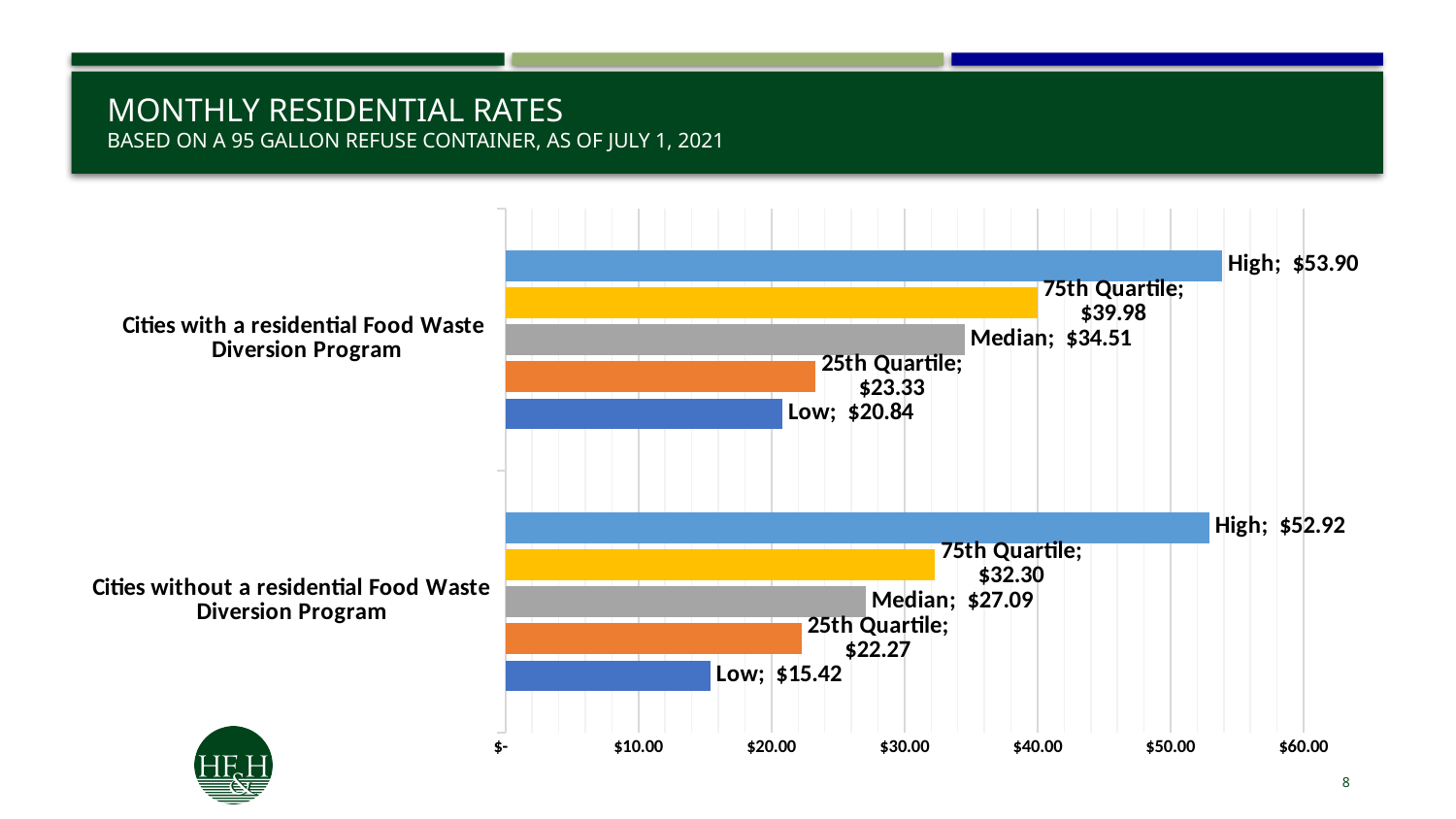
What kind of chart is shown on the slide? Bar chart Which category has the lower Low value? Cities without a residential Food Waste Diversion Program What is the difference between the Median values of the two categories? $7.42 What is the High value for cities with a residential Food Waste Diversion Program? $53.90 What is the title of the slide's chart? Monthly Residential Rates Which is larger: the 75th Quartile for cities with a program or the 75th Quartile for cities without a program? Cities with a residential Food Waste Diversion Program What is the 75th Quartile value for cities without a residential Food Waste Diversion Program? $32.30 How many categories are shown on the chart? 2 What is the Low value for cities with a residential Food Waste Diversion Program? $20.84 Is the 25th Quartile value for cities without a residential Food Waste Diversion Program greater or less than $30.00? less What is the Median value for cities without a residential Food Waste Diversion Program? $27.09 What is the difference between the Low values of the two categories? $5.42